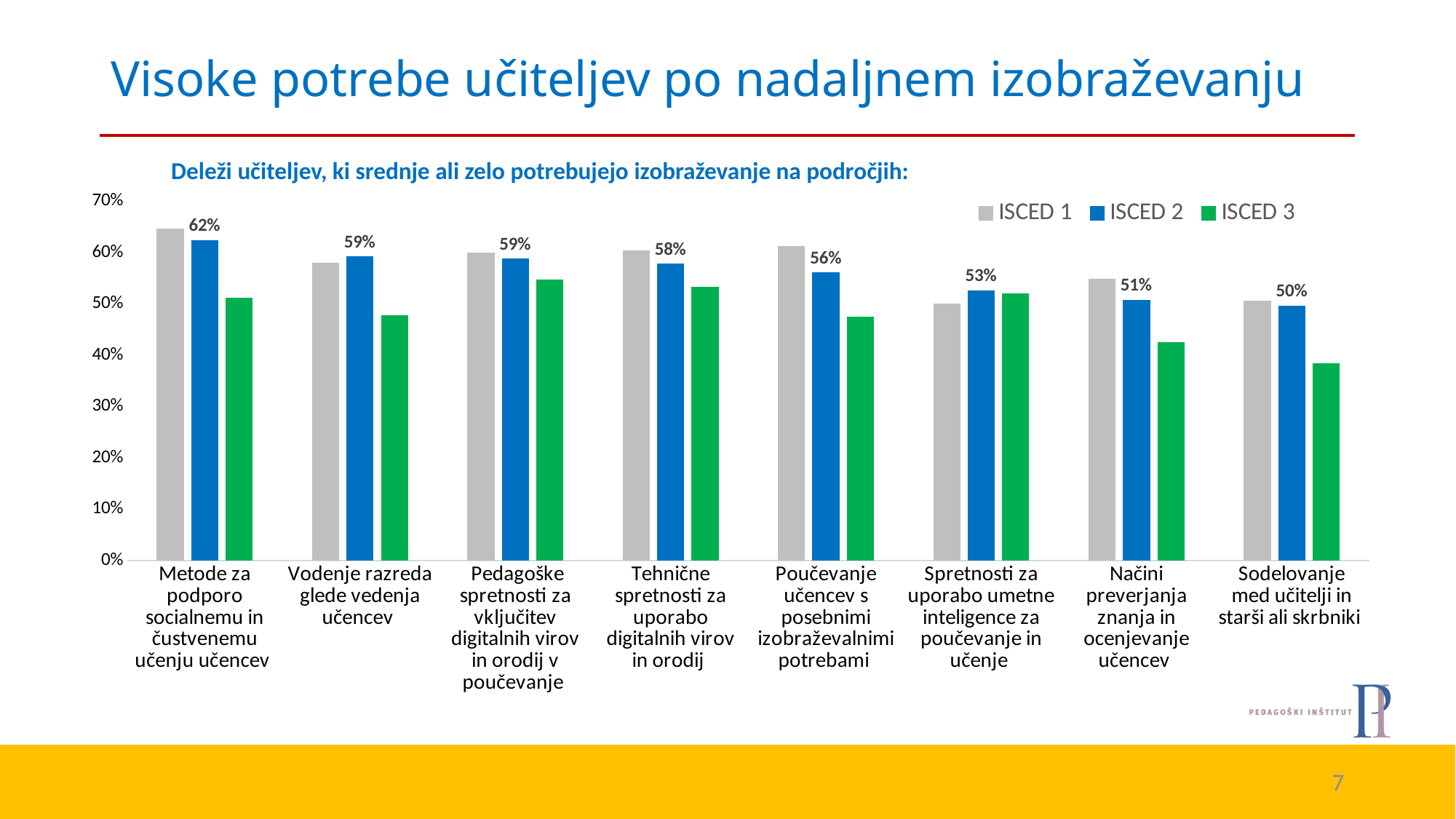
Which category has the lowest ISCED 2 value? Sodelovanje med učitelji in starši ali skrbniki What is the ISCED 2 value for "Spretnosti za uporabo umetne inteligence za poučevanje in učenje"? 53% Is the ISCED 3 value for "Sodelovanje med učitelji in starši ali skrbniki" greater or less than 40%? less Which is larger: the ISCED 1 value or the ISCED 3 value for "Sodelovanje med učitelji in starši ali skrbniki"? ISCED 1 Is the ISCED 1 value for "Metode za podporo socialnemu in čustvenemu učenju učencev" greater or less than 60%? greater Which category has the highest ISCED 2 value? Metode za podporo socialnemu in čustvenemu učenju učencev What is the ISCED 2 value for "Metode za podporo socialnemu in čustvenemu učenju učencev"? 62% What is the difference between the ISCED 2 values for "Tehnične spretnosti za uporabo digitalnih virov in orodij" and "Načini preverjanja znanja in ocenjevanje učencev"? 7 percentage points What is the ISCED 2 value for "Sodelovanje med učitelji in starši ali skrbniki"? 50% How many categories are shown on the x axis? 8 Do the ISCED 2 values rise or fall from left to right across the categories? fall How many series does the legend list? 3